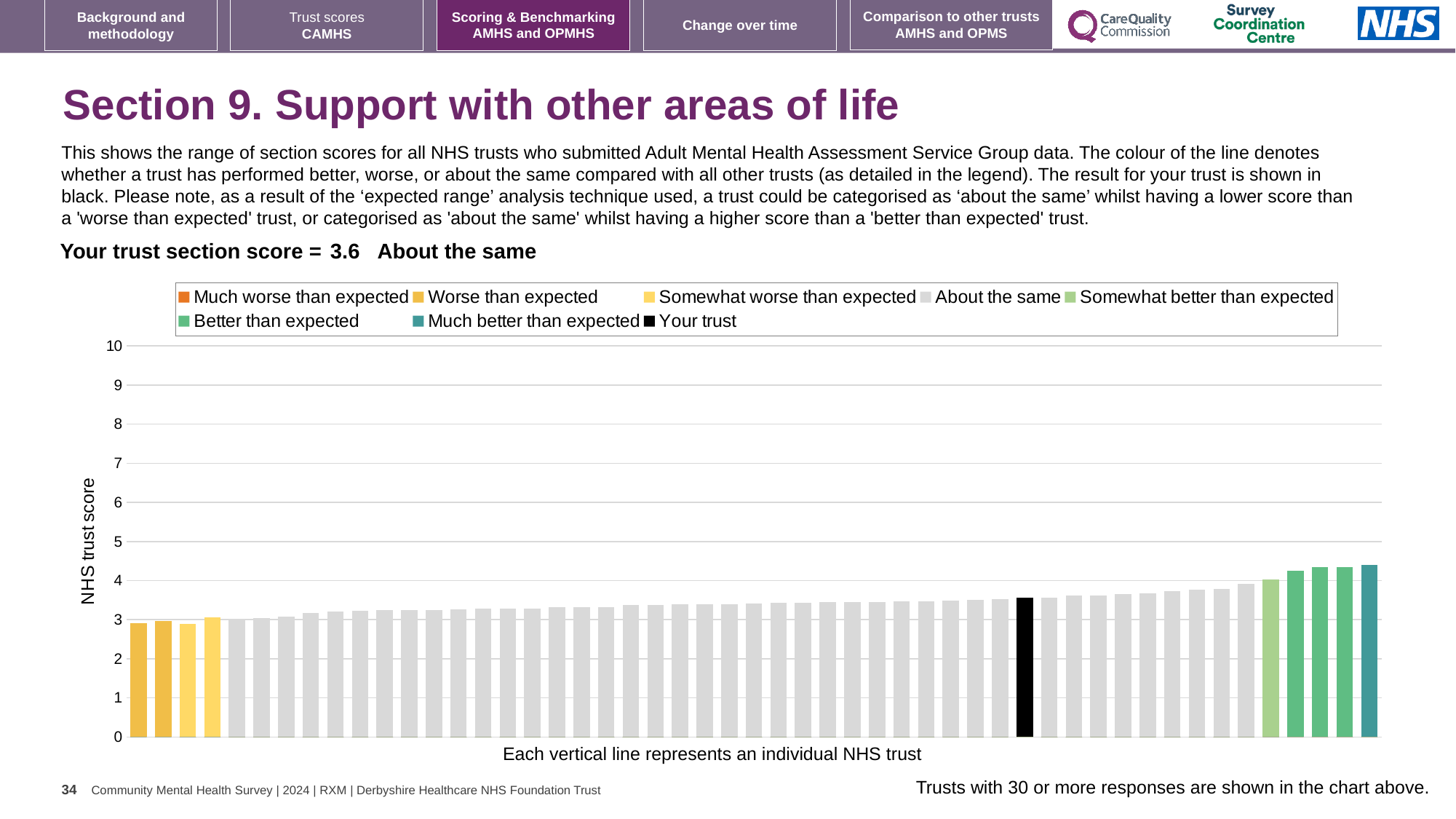
What kind of chart is shown on the slide? bar chart Is the value for your trust (the black bar) greater or less than 4? less Which legend category does the highest bar in the chart belong to? Much better than expected How many categories does the chart legend list? 8 What is the section score for your trust shown on the slide? 3.6 Is the highest bar in the chart greater or less than 4? greater Do the bar values rise or fall from left to right along the x axis? rise How many bars are coloured as 'Better than expected'? 3 What is the label on the vertical axis of the chart? NHS trust score Is the value for your trust (the black bar) greater or less than 3? greater What colour is the bar representing your trust? black